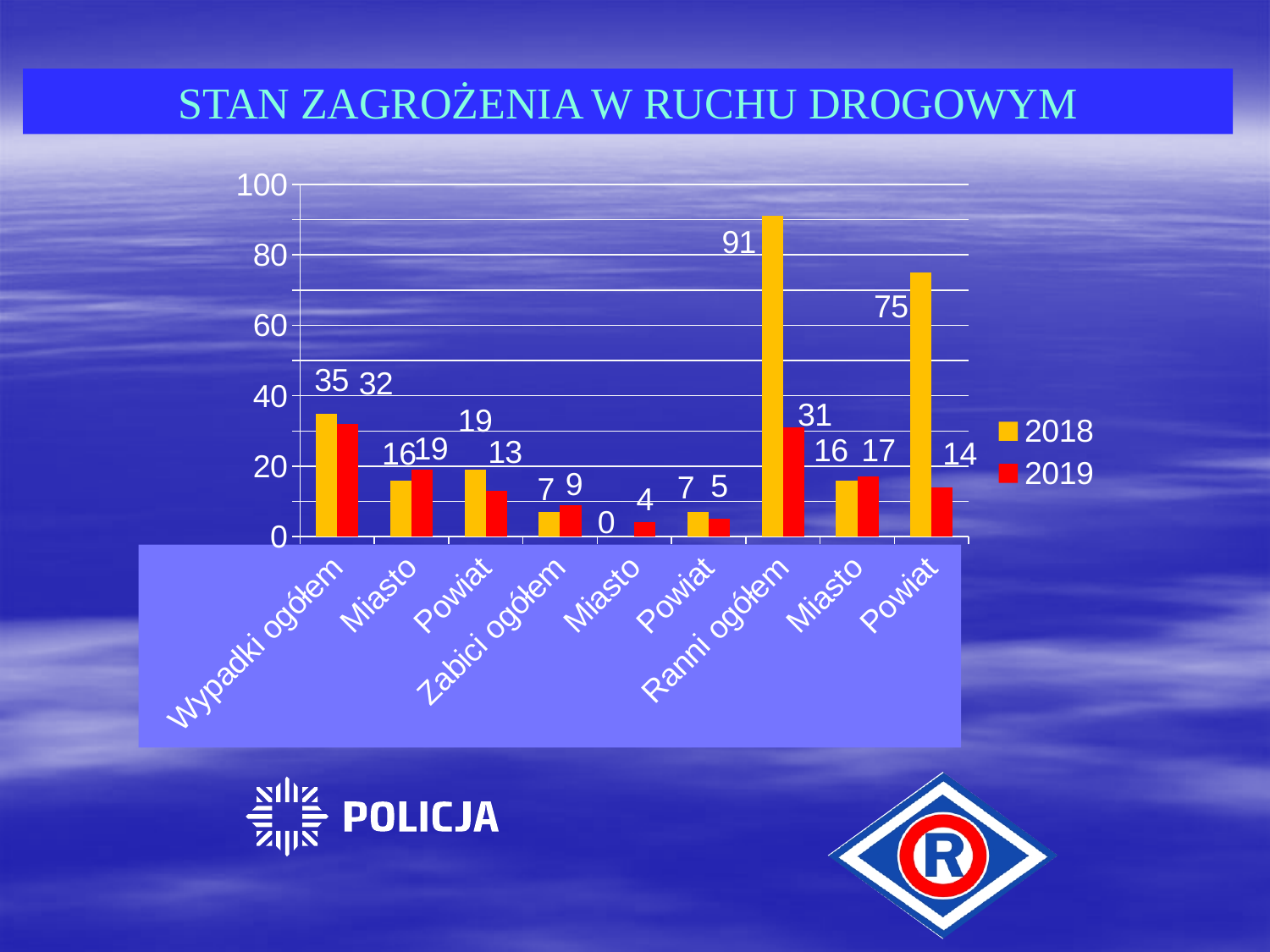
What is the difference between the 2018 and 2019 values for Wypadki ogółem? 3 What is the 2019 value for Ranni ogółem? 31 Which category has the highest 2018 value? Ranni ogółem What is the 2018 value for Wypadki ogółem? 35 Which is larger for Zabici ogółem, the 2018 value or the 2019 value? 2019 What is the 2019 value for the last Powiat category (after Ranni ogółem)? 14 What kind of chart is shown on the slide? Bar chart What is the 2018 value for Zabici ogółem? 7 Which category has the lowest 2018 value? Miasto (after Zabici ogółem) How many categories are shown on the x axis? 9 How many series does the legend list? 2 What is the difference between the 2018 and 2019 values for Ranni ogółem? 60